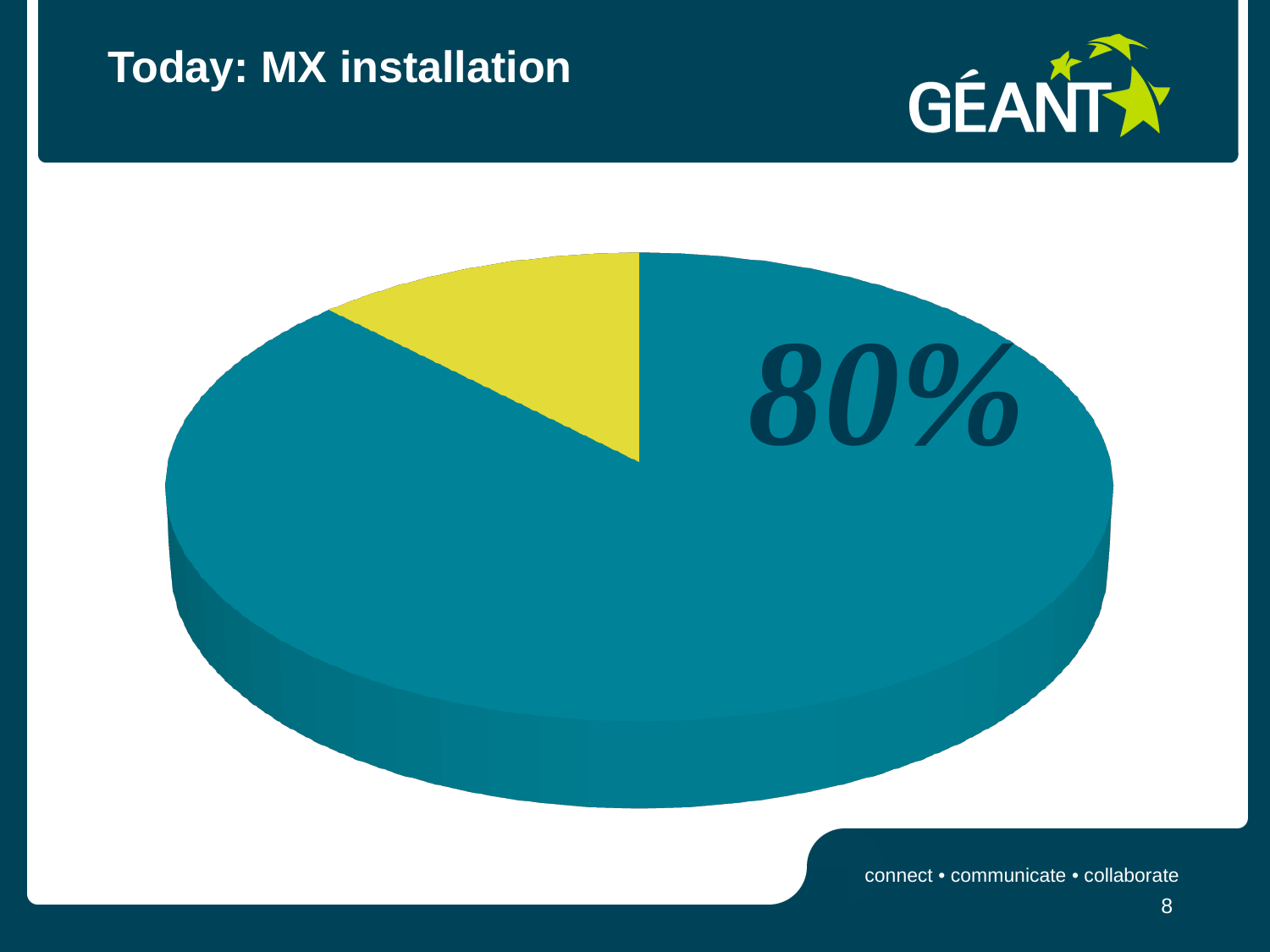
What is the title of the slide containing the pie chart? Today: MX installation What kind of chart is shown on the slide? pie chart Is the teal slice of the pie chart larger or smaller than the yellow slice? larger What percentage is printed on the large teal slice of the pie chart? 80% Is the share of the yellow slice greater or less than 50%? less How many slices does the pie chart have? 2 What colour is the slice labelled 80% in the pie chart? teal Is the share of the teal slice greater or less than 50%? greater Which slice of the pie chart is the smallest, the teal one or the yellow one? the yellow one Which slice of the pie chart is the largest, the teal one or the yellow one? the teal one